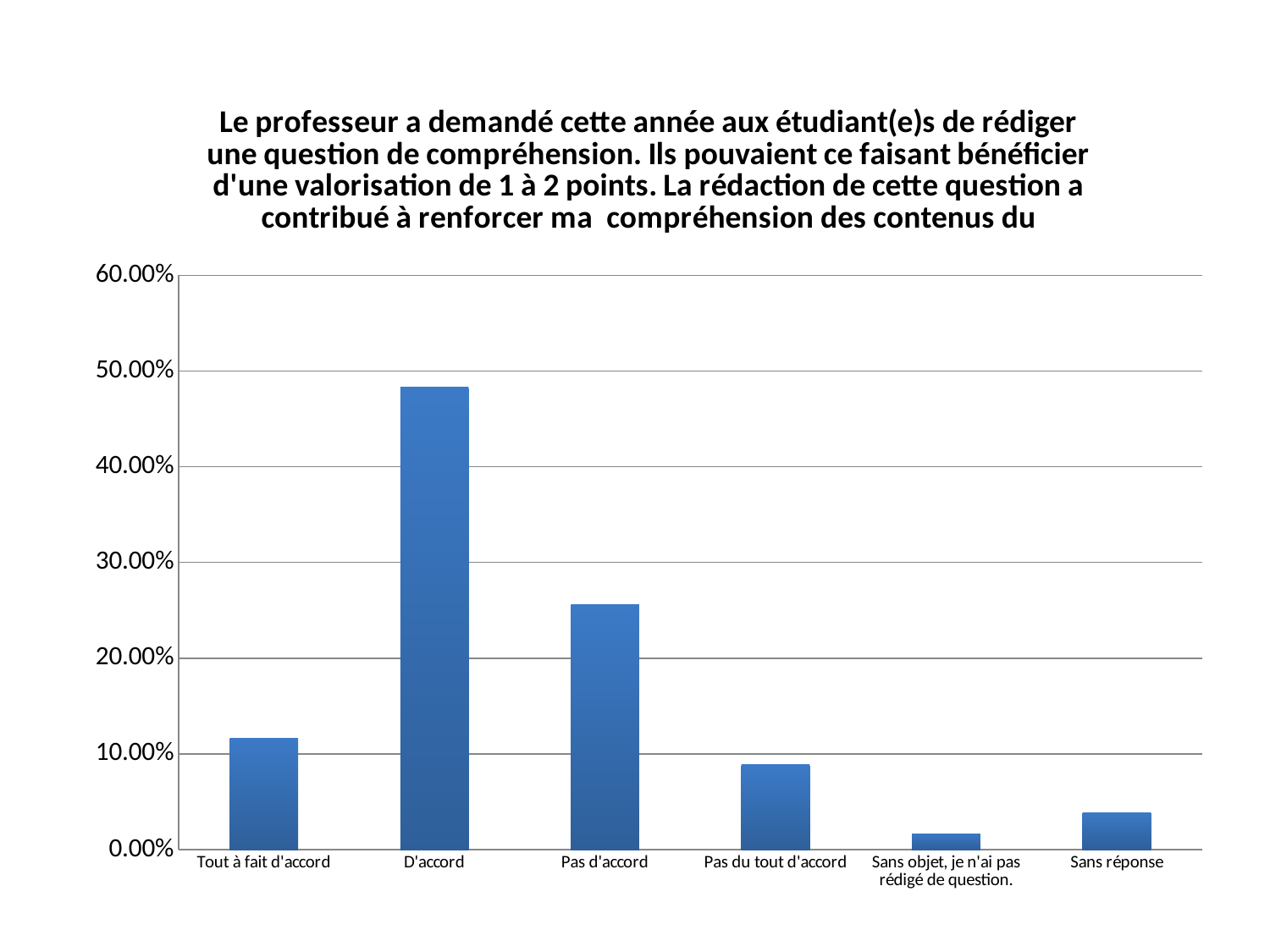
Is the value for Pas d'accord greater or less than 30.00%? less What kind of chart is shown on the slide? bar chart Is the value for Tout à fait d'accord greater or less than 10.00%? greater Is the value for Pas du tout d'accord greater or less than 10.00%? less Which is larger, the value for Pas d'accord or the value for Tout à fait d'accord? Pas d'accord Which is larger, the value for Sans réponse or the value for Pas du tout d'accord? Pas du tout d'accord What is the highest value shown on the y axis? 60.00% Which category has the lowest value? Sans objet, je n'ai pas rédigé de question. Which category has the highest value? D'accord What colour are the bars in the chart? blue How many categories are shown on the x axis? 6